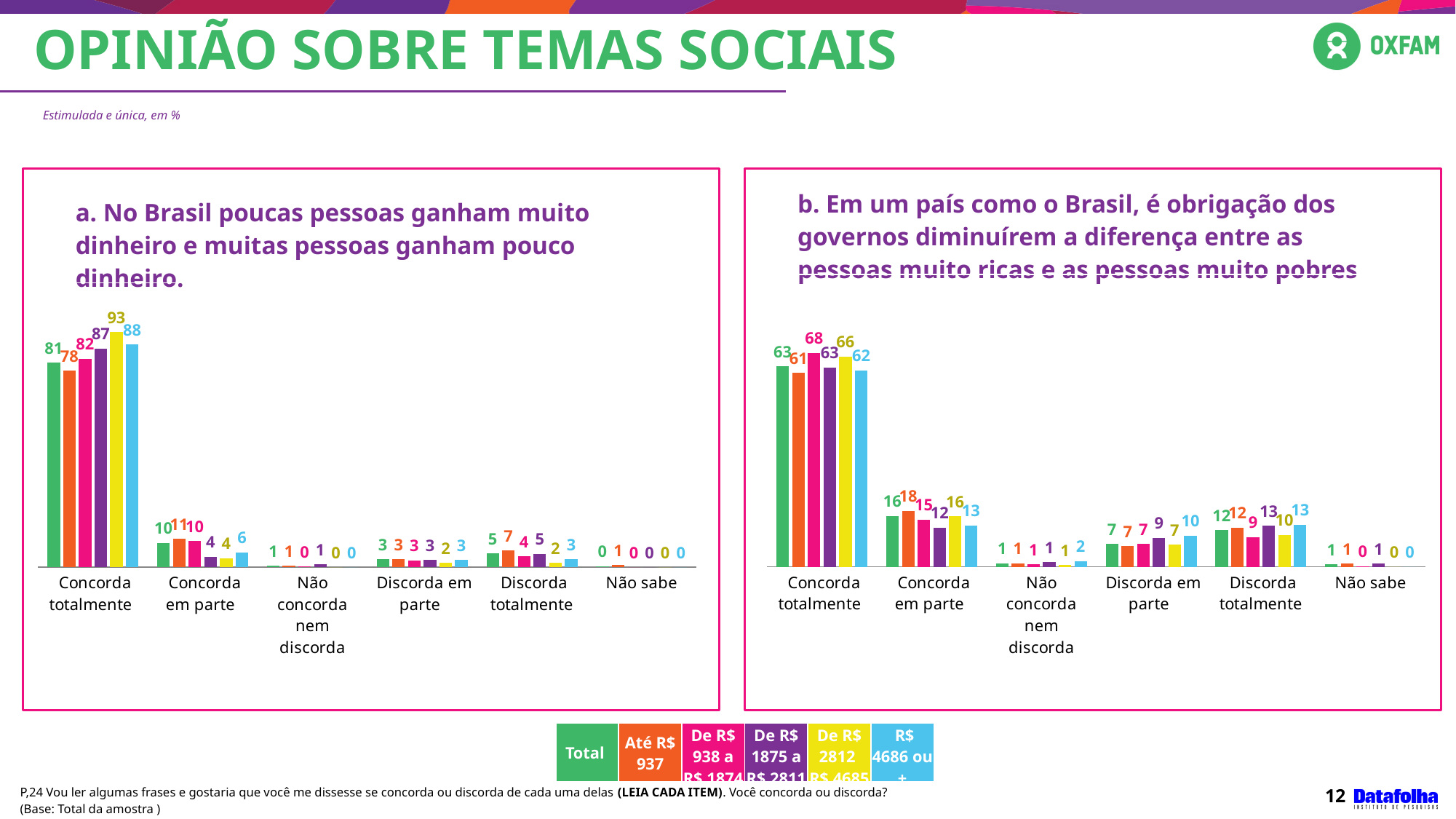
In the right chart, which is larger for "Concorda em parte": the Total value or the "Até R$ 937" value? Até R$ 937 What type of chart is used in the right chart (b.)? Bar chart In the left chart, what is the value for "Até R$ 937" in the "Discorda totalmente" category? 7 In the left chart, which income series has the highest value for "Concorda totalmente"? De R$ 2812 a R$ 4685 In the right chart, which response category has the lowest Total value? Não concorda nem discorda and Não sabe (both 1) How many response categories are shown on the x axis of the left chart? 6 In the left chart (a. No Brasil poucas pessoas ganham muito dinheiro...), what is the Total value for "Concorda totalmente"? 81 How many series does the legend at the bottom of the slide list? 6 In the right chart, what is the difference between the Total values for "Concorda totalmente" (63) and "Discorda totalmente" (12)? 51 In the left chart, what is the difference between the "Concorda totalmente" values for "De R$ 2812 a R$ 4685" (93) and "Até R$ 937" (78)? 15 In the right chart, what is the value for "R$ 4686 ou +" in the "Discorda em parte" category? 10 In the right chart (b. Em um país como o Brasil...), what is the Total value for "Concorda totalmente"? 63